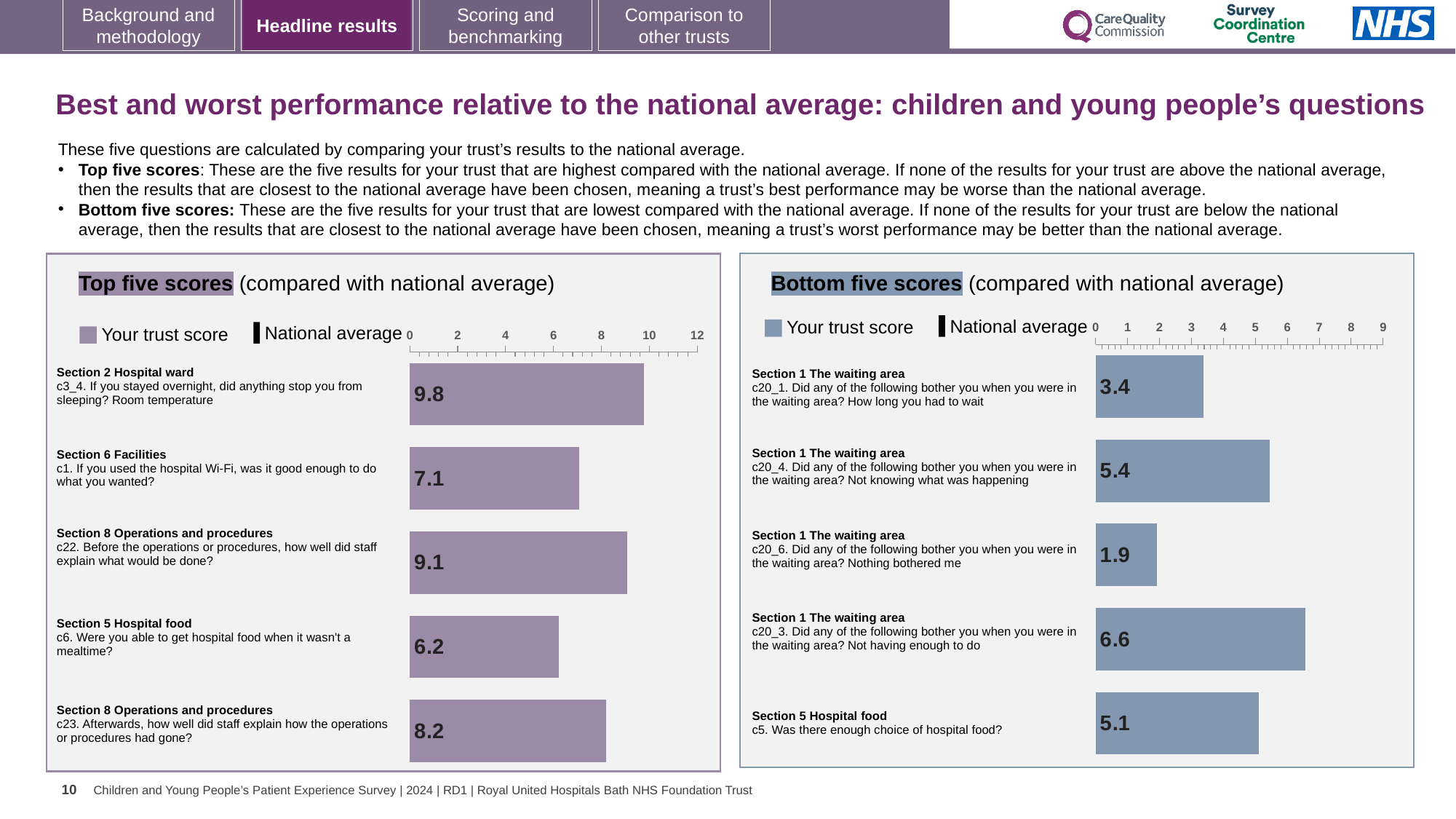
How many entries does the legend of the Bottom five scores chart list? 2 In the Top five scores chart, how many questions are plotted? 5 In the Bottom five scores chart, what is the trust score for c20_6 (Nothing bothered me)? 1.9 In the Bottom five scores chart, is the score for c20_3 greater or less than 6? greater In the Top five scores chart, which question has the lowest trust score? c6. Were you able to get hospital food when it wasn't a mealtime? In the Bottom five scores chart, which is larger: the score for c20_4 or the score for c5? c20_4 In the Top five scores chart, what is the trust score for c3_4 (did anything stop you from sleeping? Room temperature)? 9.8 In the Top five scores chart, what is the trust score for c1 (was the hospital Wi-Fi good enough)? 7.1 In the Bottom five scores chart, what is the difference between the scores for c20_1 and c20_6? 1.5 In the Bottom five scores chart, which question has the highest trust score? c20_3. Not having enough to do In the Top five scores chart, what is the difference between the scores for c22 and c23? 0.9 What kind of chart is used in the Top five scores panel? Bar chart